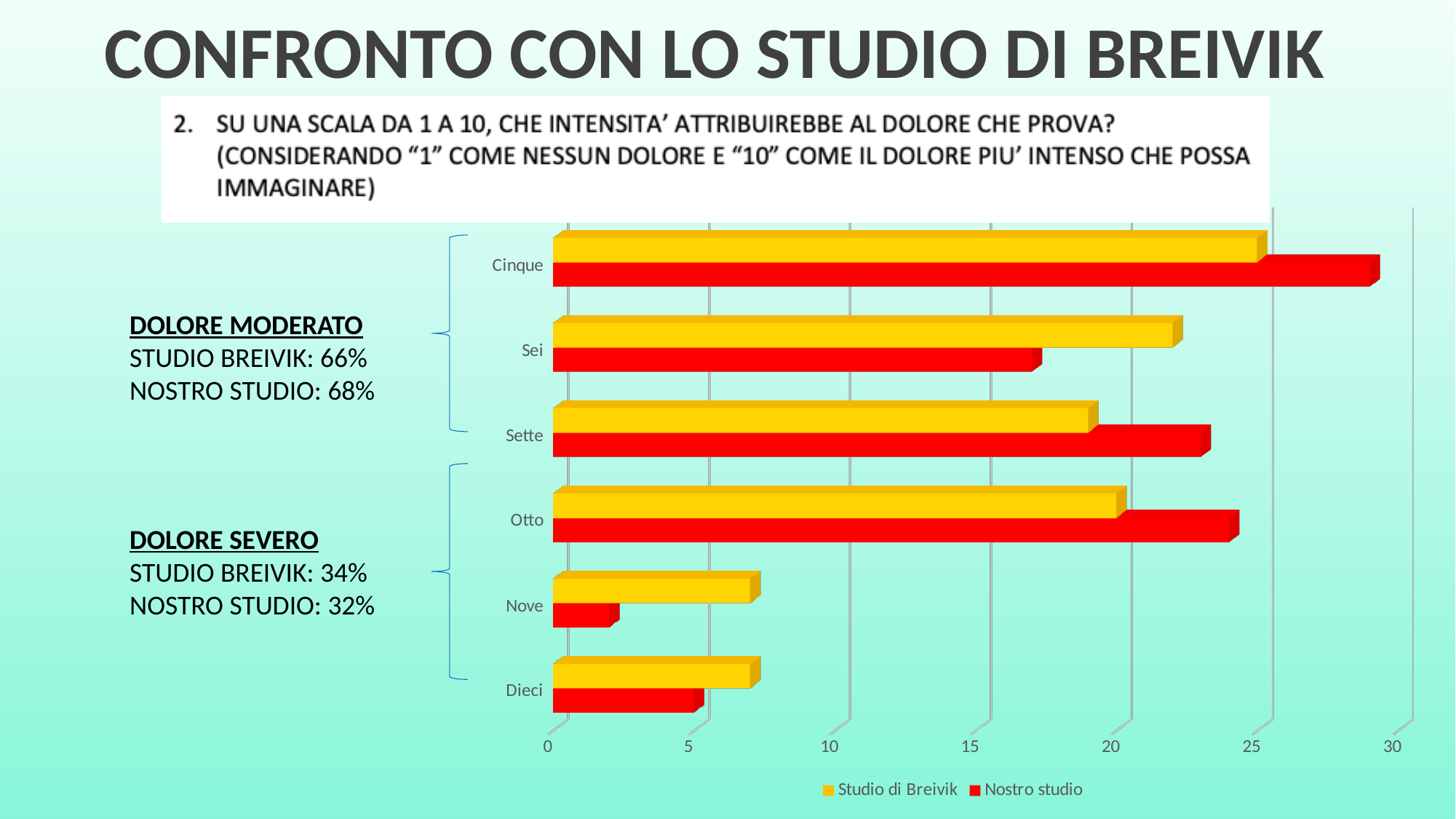
Is the Nostro studio value for Nove greater or less than 5? less For the category Cinque, which series has the larger value, Studio di Breivik or Nostro studio? Nostro studio Which colour represents the Nostro studio series in the chart? Red Which category has the highest value for the Nostro studio series? Cinque Which category has the lowest value for the Nostro studio series? Nove Is the Studio di Breivik value for Sei greater or less than 20? greater What kind of chart is shown on the slide? Bar chart Which category has the highest value for the Studio di Breivik series? Cinque For the category Sei, which series has the larger value, Studio di Breivik or Nostro studio? Studio di Breivik How many categories are shown on the chart's vertical axis? 6 Is the Nostro studio value for Cinque greater or less than 25? greater How many series does the chart legend list? 2